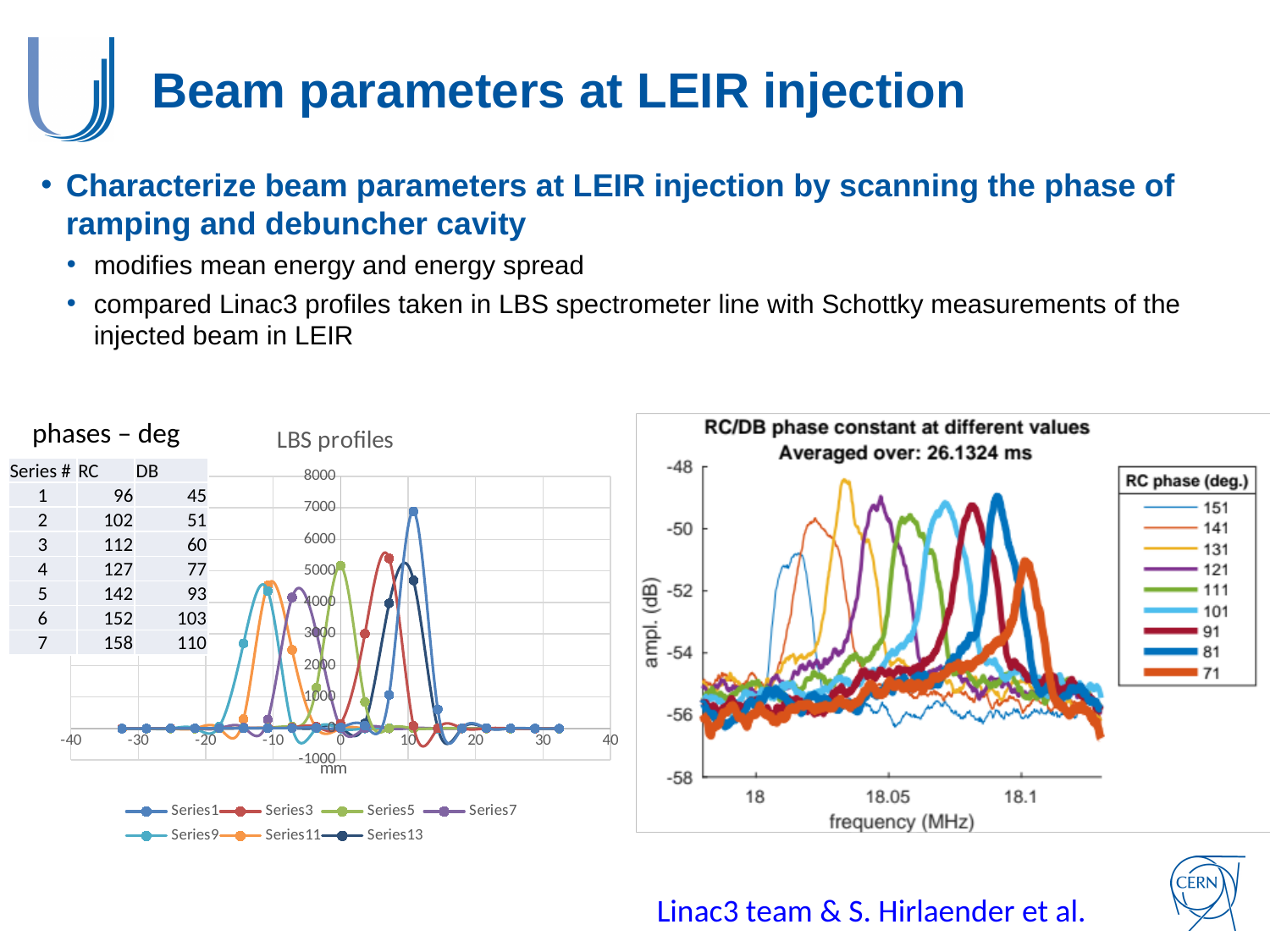
What kind of chart is the 'RC/DB phase constant at different values' chart? line chart In the 'RC/DB phase constant at different values' chart, as the RC phase decreases from 151 to 71, do the peaks move to higher or lower frequency? higher What is the title of the legend in the 'RC/DB phase constant at different values' chart? RC phase (deg.) How many RC phase values does the legend of the 'RC/DB phase constant at different values' chart list? 9 In the LBS profiles chart, which series has the highest peak? Series1 In the LBS profiles chart, is the peak value of Series1 greater or less than 6000? greater In the LBS profiles chart, is the peak value of Series5 greater or less than 6000? less In the 'RC/DB phase constant at different values' chart, is the peak of the 151 deg curve greater or less than -50 dB? less How many series does the legend of the LBS profiles chart list? 7 What kind of chart is the LBS profiles chart? line chart What is the x-axis label of the LBS profiles chart? mm In the LBS profiles chart, is the peak of Series1 higher or lower than the peak of Series3? higher